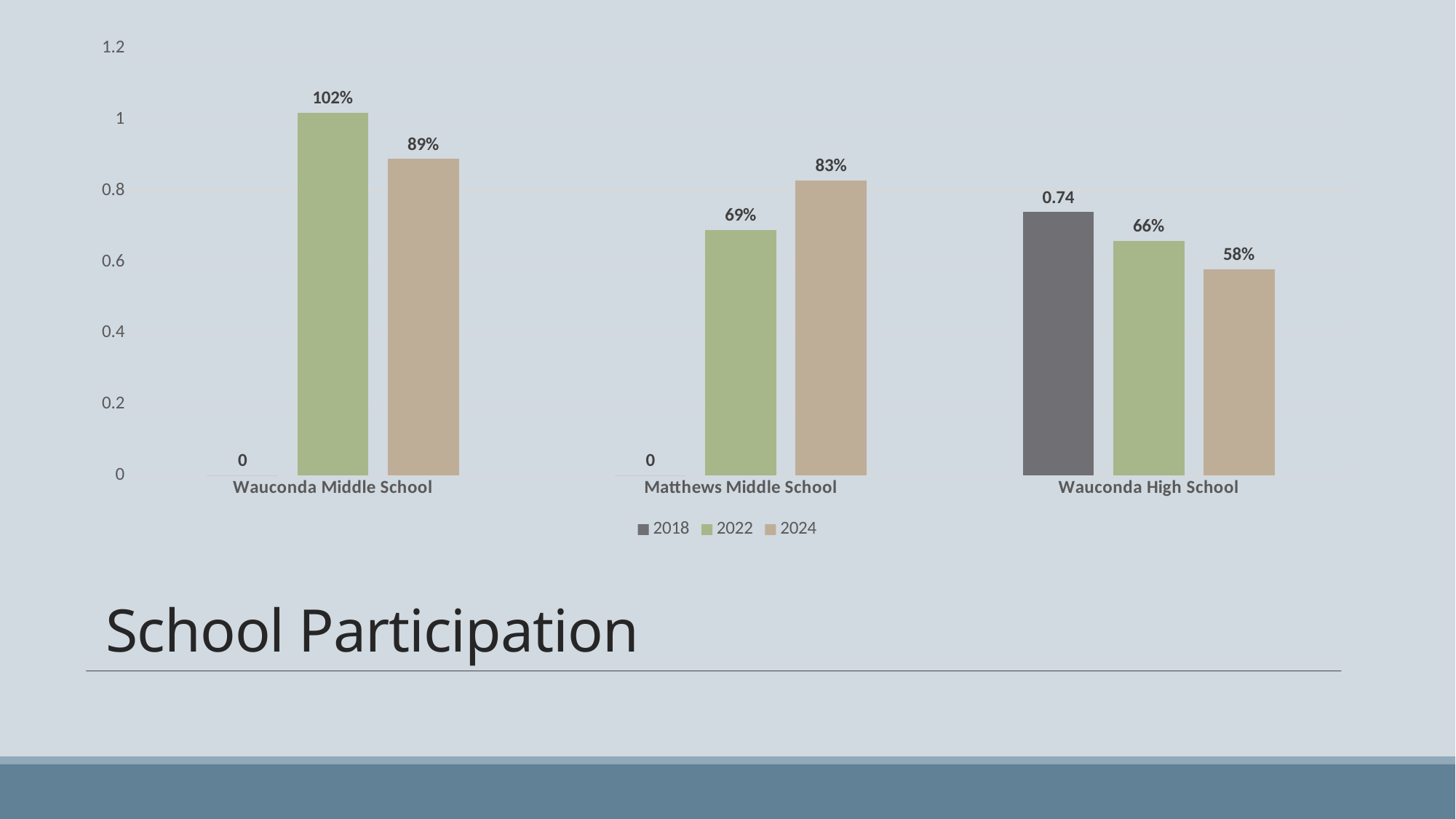
What is the 2022 value for Wauconda Middle School? 102% What is the 2024 value for Wauconda High School? 58% What is the difference between the 2022 and 2024 values for Matthews Middle School? 14% How many schools are shown on the x axis? 3 How many series does the legend list? 3 What is the 2018 value for Wauconda High School? 0.74 What kind of chart is shown on the slide? Bar chart What is the title of the slide? School Participation Which is larger for Wauconda High School, the 2022 value or the 2024 value? 2022 Which school has the lowest 2024 value? Wauconda High School What is the 2024 value for Matthews Middle School? 83% Which school has the highest 2022 value? Wauconda Middle School